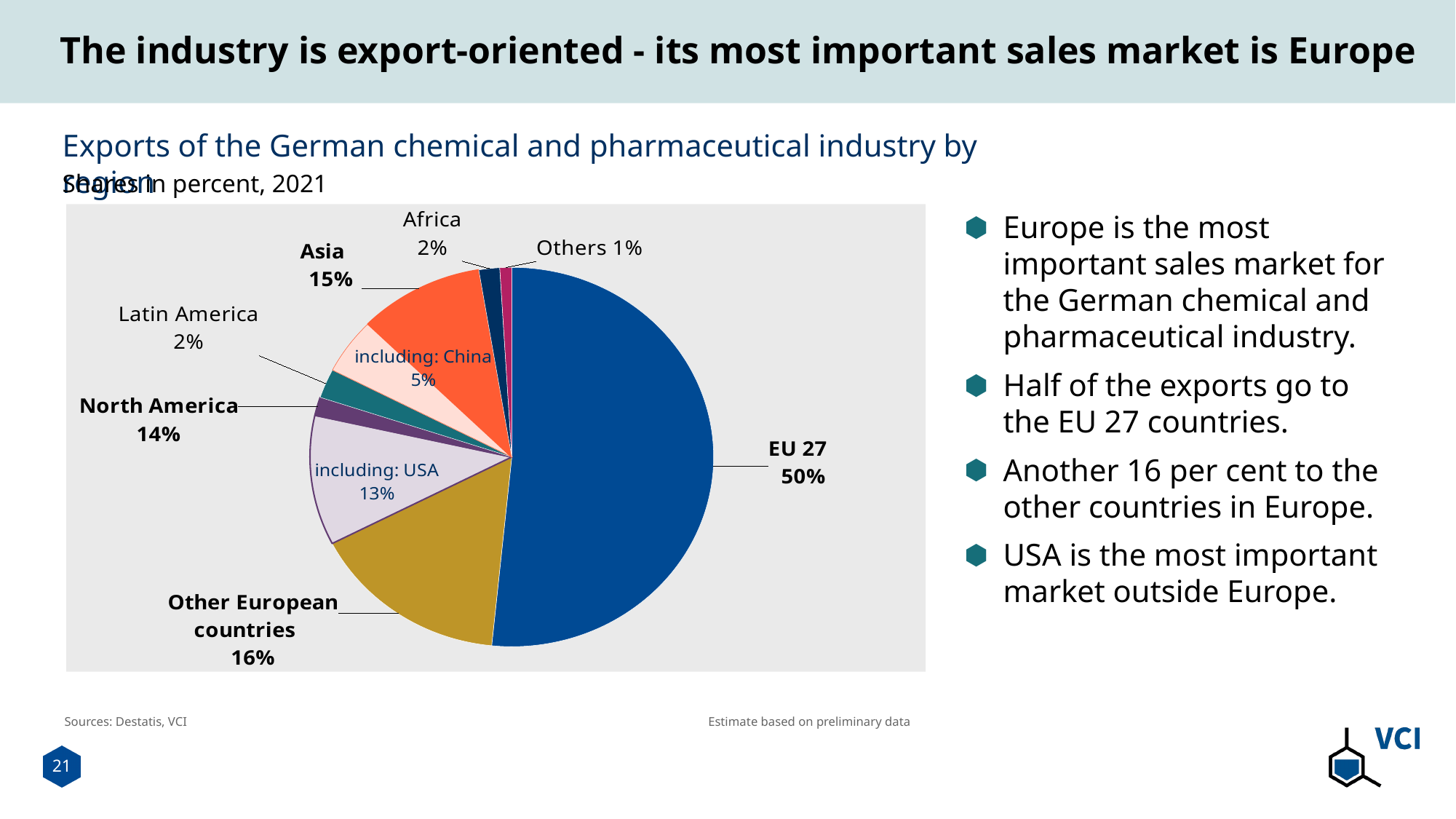
Which region has the smallest share of exports? Others What share of exports goes to Asia? 15% What is the title of the chart? Exports of the German chemical and pharmaceutical industry by region Which year does the chart's data refer to? 2021 What kind of chart is shown on the slide? Pie chart What share of exports goes to the EU 27? 50% What is the difference in percentage points between the share for Other European countries and the share for North America? 2 What is the combined share of exports going to the EU 27 and Other European countries? 66% Which region has the largest share of exports? EU 27 Which has a larger share of exports, Asia or North America? Asia What share of exports goes to the USA? 13% What share of exports goes to China? 5%